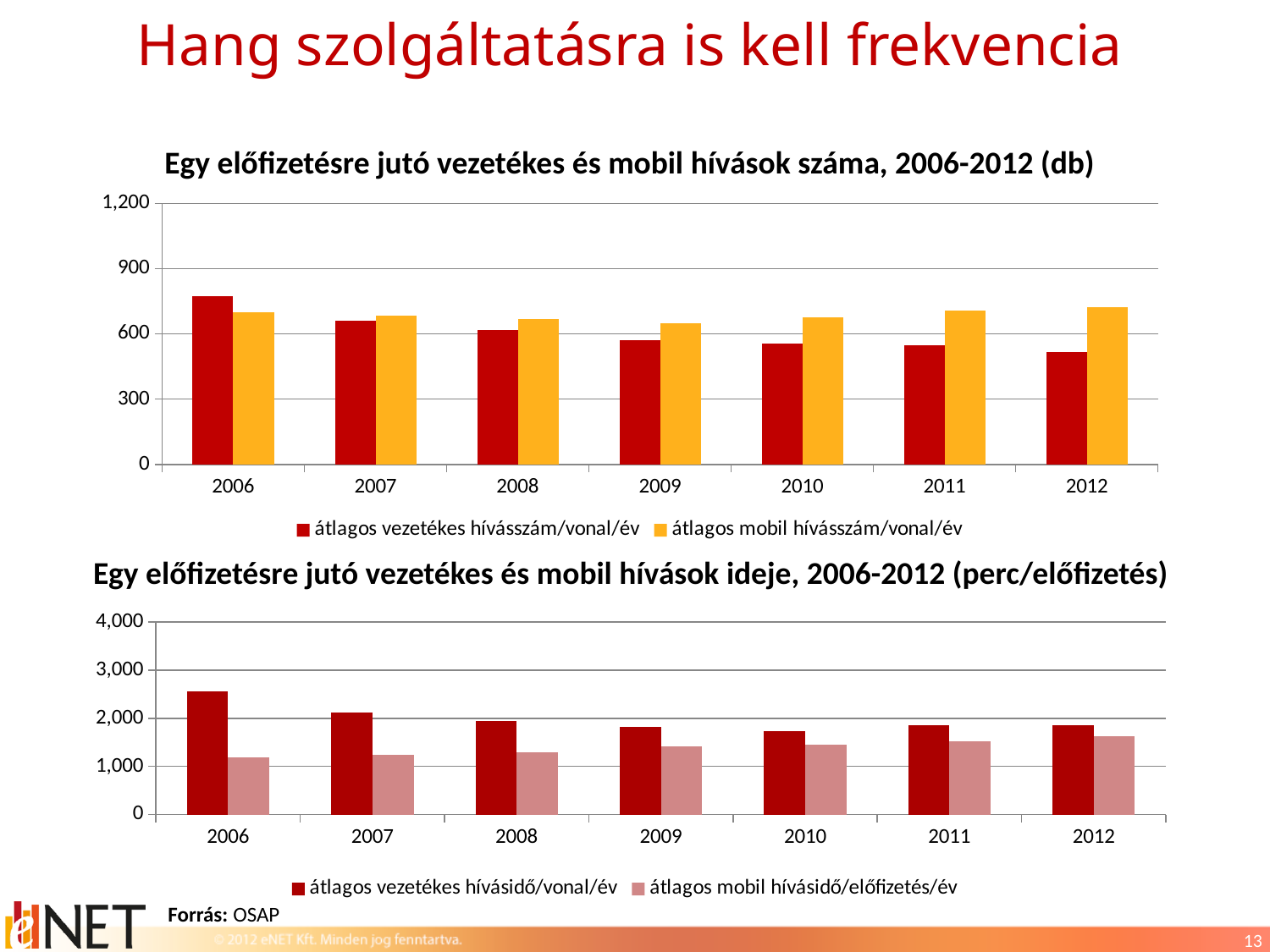
In the top chart, is the 2012 value for 'átlagos vezetékes hívásszám/vonal/év' greater or less than 600? less In the bottom chart, which year has the highest value for 'átlagos vezetékes hívásidő/vonal/év'? 2006 In the bottom chart, which is larger in 2012: 'átlagos vezetékes hívásidő/vonal/év' or 'átlagos mobil hívásidő/előfizetés/év'? átlagos vezetékes hívásidő/vonal/év In the top chart, does the 'átlagos vezetékes hívásszám/vonal/év' series rise or fall from 2006 to 2012? Fall In the top chart, which year has the highest value for 'átlagos vezetékes hívásszám/vonal/év'? 2006 In the top chart, is the 2012 value for 'átlagos mobil hívásszám/vonal/év' greater or less than 600? greater In the bottom chart, is the 2006 value for 'átlagos vezetékes hívásidő/vonal/év' greater or less than 2,000? greater How many series does the legend of the bottom chart list? 2 What type of chart is the top chart, 'Egy előfizetésre jutó vezetékes és mobil hívások száma, 2006-2012 (db)'? Bar chart How many years are shown on the x axis of the top chart? 7 In the top chart, which year has the lowest value for 'átlagos vezetékes hívásszám/vonal/év'? 2012 In the bottom chart, does the 'átlagos mobil hívásidő/előfizetés/év' series rise or fall from 2006 to 2012? Rise